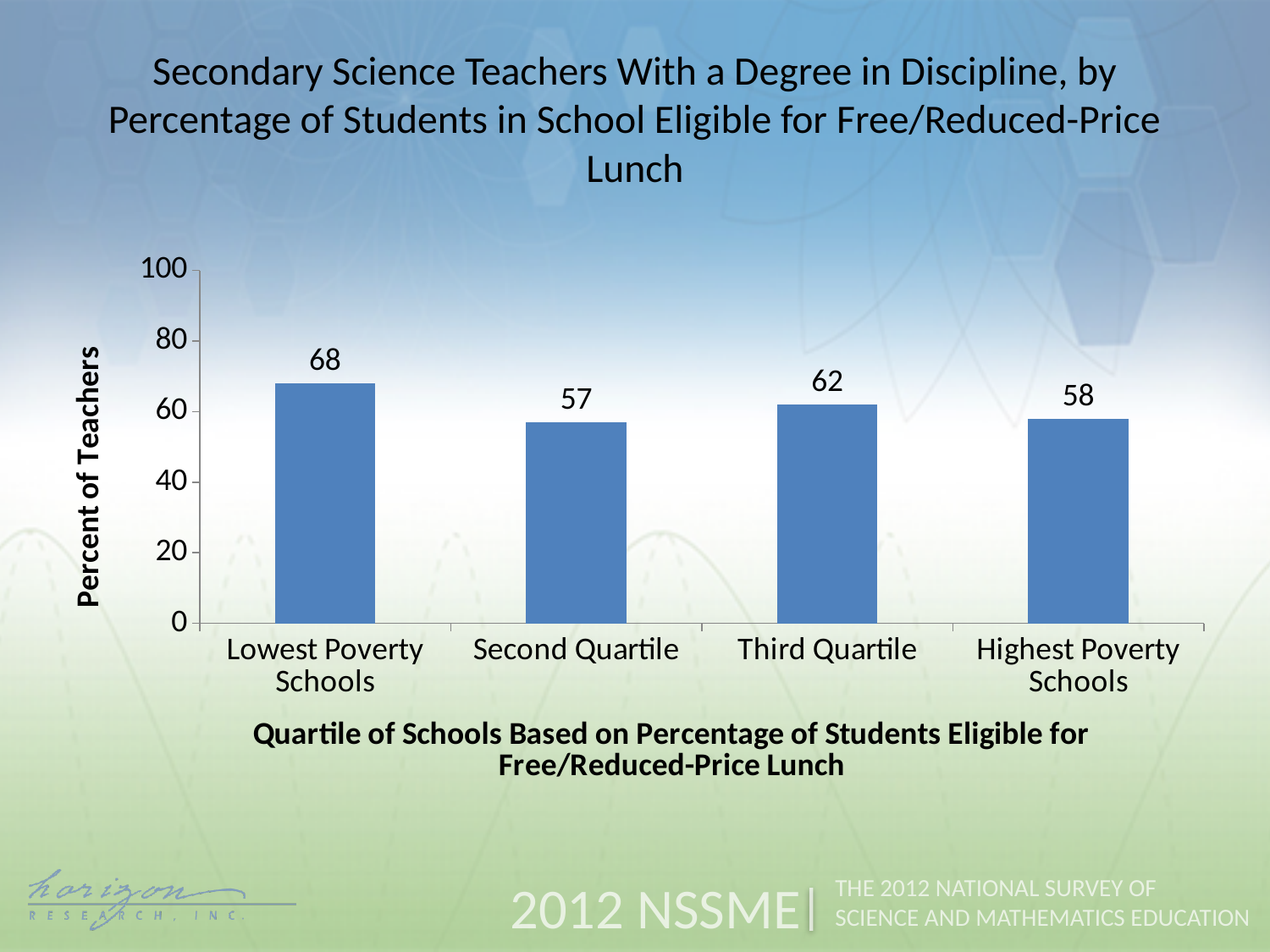
Which is larger, the value for Third Quartile or the value for Second Quartile? Third Quartile What is the value for Third Quartile? 62 What is the label of the y axis? Percent of Teachers What kind of chart is shown on the slide? bar chart Which category has the highest value? Lowest Poverty Schools Is the value for Second Quartile greater or less than 60? less How many categories are shown on the x axis? 4 Which category has the lowest value? Second Quartile What is the value for Lowest Poverty Schools? 68 What is the value for Highest Poverty Schools? 58 What is the value for Second Quartile? 57 What is the difference between the values for Lowest Poverty Schools and Highest Poverty Schools? 10